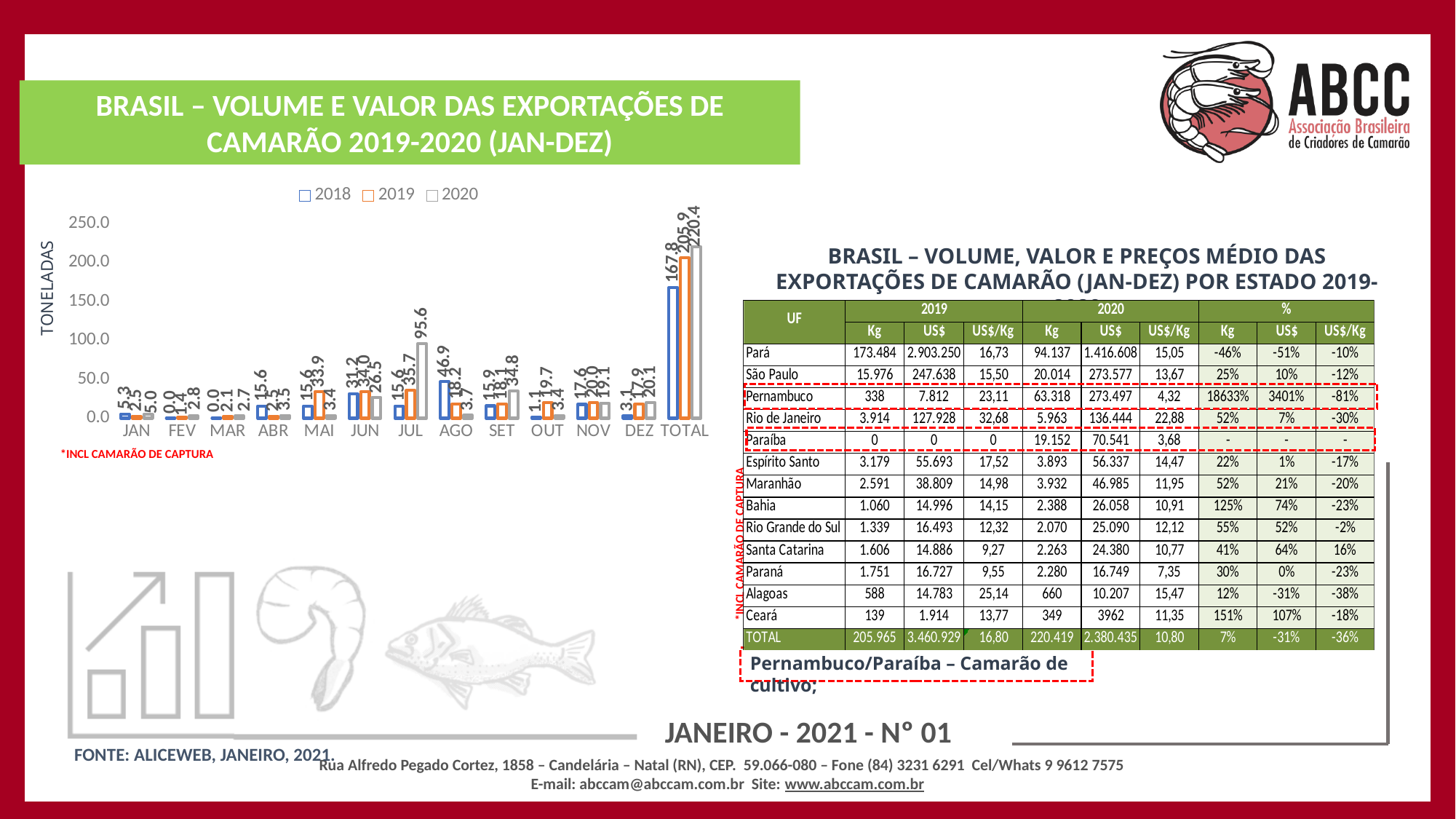
What is the TOTAL value for 2020 in the chart? 220.4 What is the label on the vertical axis of the chart? TONELADAS Is the TOTAL value for 2018 greater or less than 150? greater For JUN, which series has the larger value, 2018 or 2019? 2019 What is the value for AGO in the 2018 series? 46.9 How many series does the chart legend list? 3 What is the value for JUL in the 2020 series? 95.6 What is the difference between the TOTAL values for 2020 and 2019? 14.5 What is the value for MAI in the 2019 series? 33.9 What is the difference between the TOTAL values for 2019 and 2018? 38.1 What kind of chart is shown on the slide? bar chart Among the months (excluding TOTAL), which month has the highest 2020 value? JUL